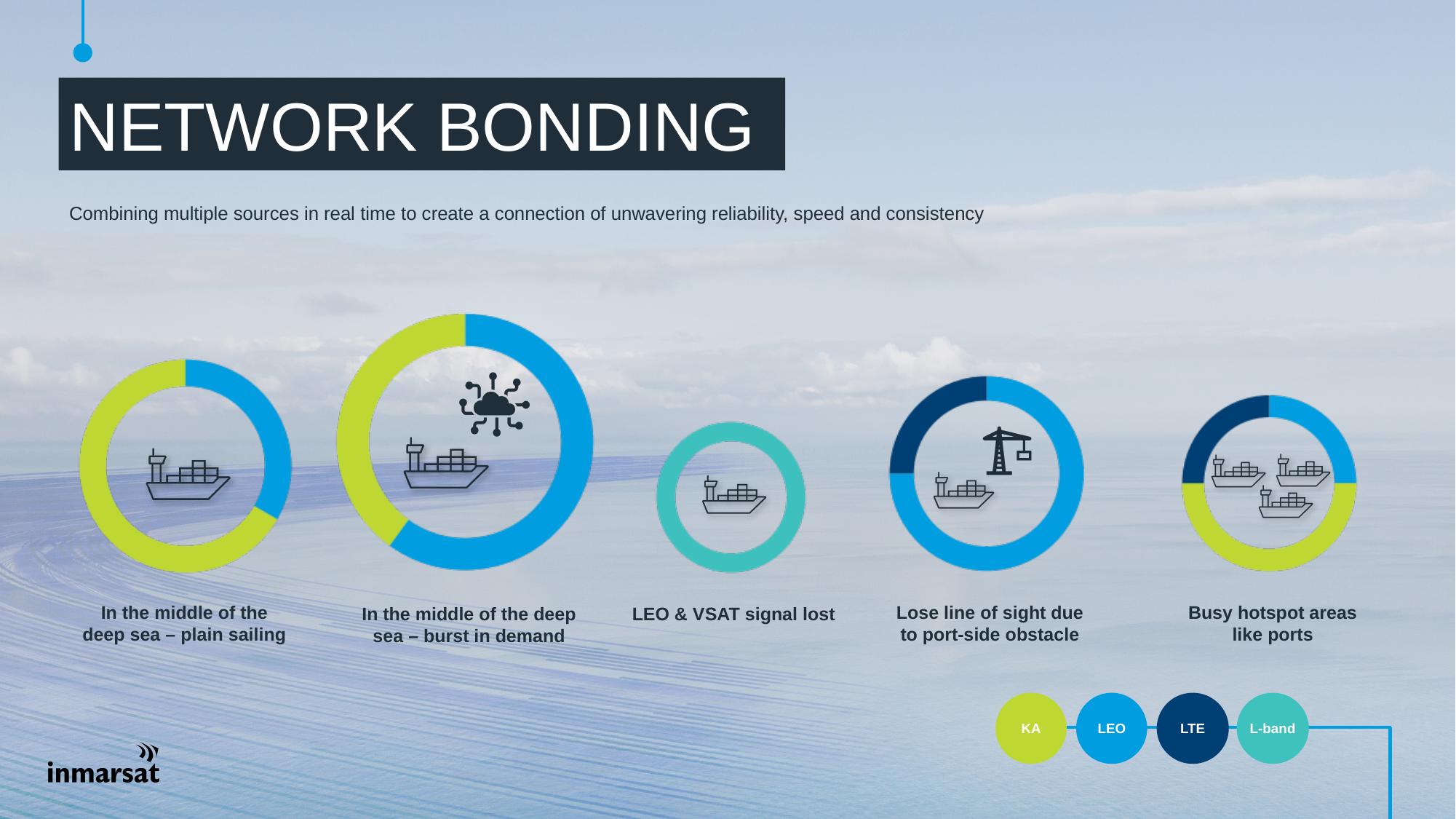
How many network sources does the legend at the bottom of the slide list? 4 How many donut charts are shown on the slide? 5 According to the legend, which colour represents LTE? Dark blue According to the legend, which network source is shown in lime green? KA What kind of charts are used on the slide to show the network sources in each scenario? Donut charts How many network sources are shown in the 'In the middle of the deep sea – plain sailing' chart? 2 In the 'In the middle of the deep sea – plain sailing' chart, which takes the larger share: KA or LEO? KA In the 'In the middle of the deep sea – burst in demand' chart, which takes the larger share: KA or LEO? LEO Which network source makes up the entire 'LEO & VSAT signal lost' chart? L-band How many network sources are shown in the 'Busy hotspot areas like ports' chart? 3 In the 'Lose line of sight due to port-side obstacle' chart, which takes the larger share: LEO or LTE? LEO In the 'Busy hotspot areas like ports' chart, which network source has the largest share? KA